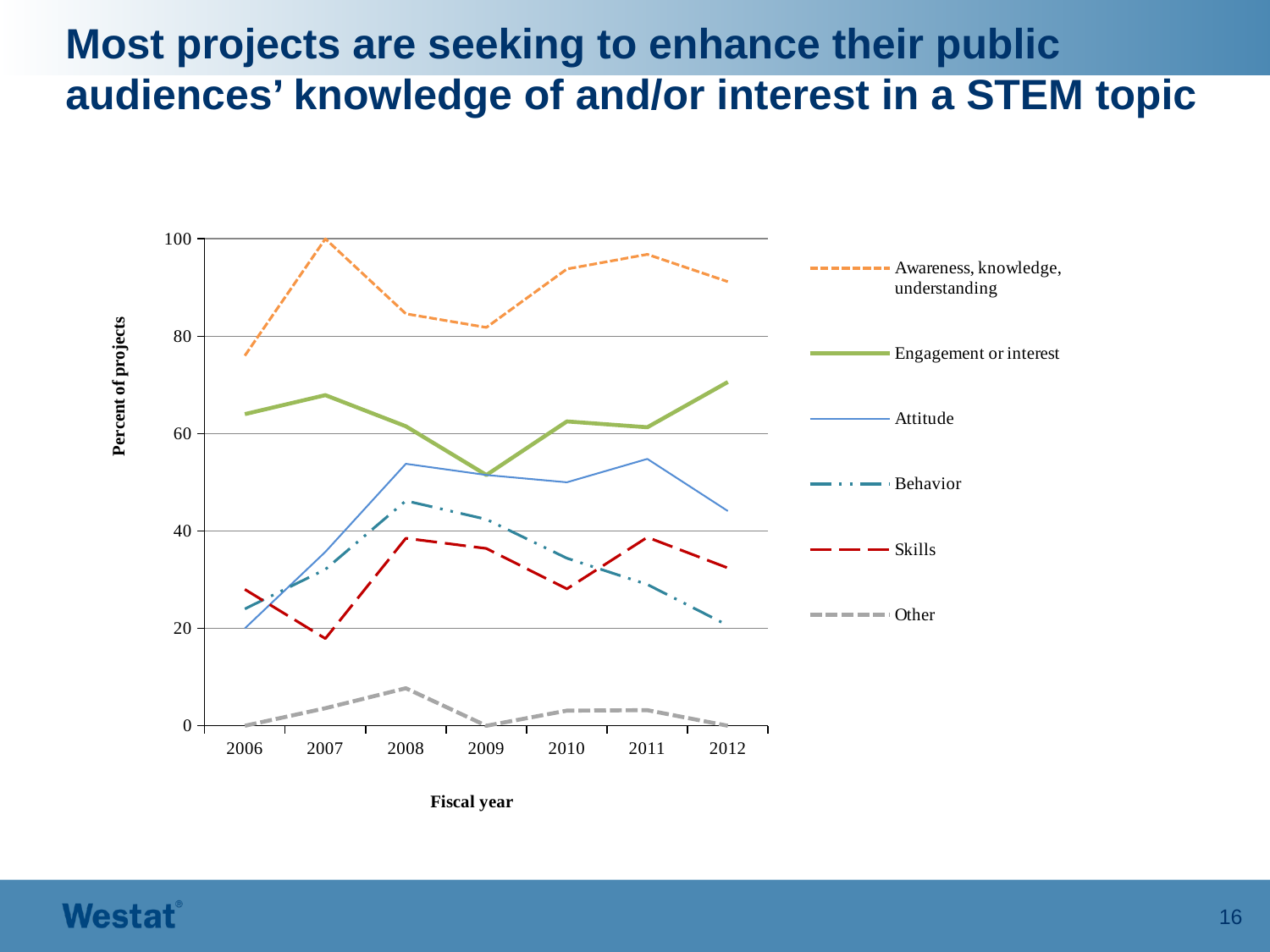
What kind of chart is shown on the slide? line chart Which is larger in 2011, the value for Attitude or the value for Skills? Attitude Does the Engagement or interest series rise or fall from 2009 to 2012? rise Is the value for Awareness, knowledge, understanding in 2009 greater or less than 80? greater What is the value for Other in fiscal year 2006? 0 In which fiscal year does the Awareness, knowledge, understanding series reach its highest value? 2007 Is the value for Skills in 2007 greater or less than 20? less What is the value for Awareness, knowledge, understanding in fiscal year 2007? 100 Is the value for Engagement or interest in 2012 greater or less than 60? greater How many fiscal years are plotted along the x axis? 7 How many series does the legend list? 6 Which series has the lowest values across all fiscal years? Other